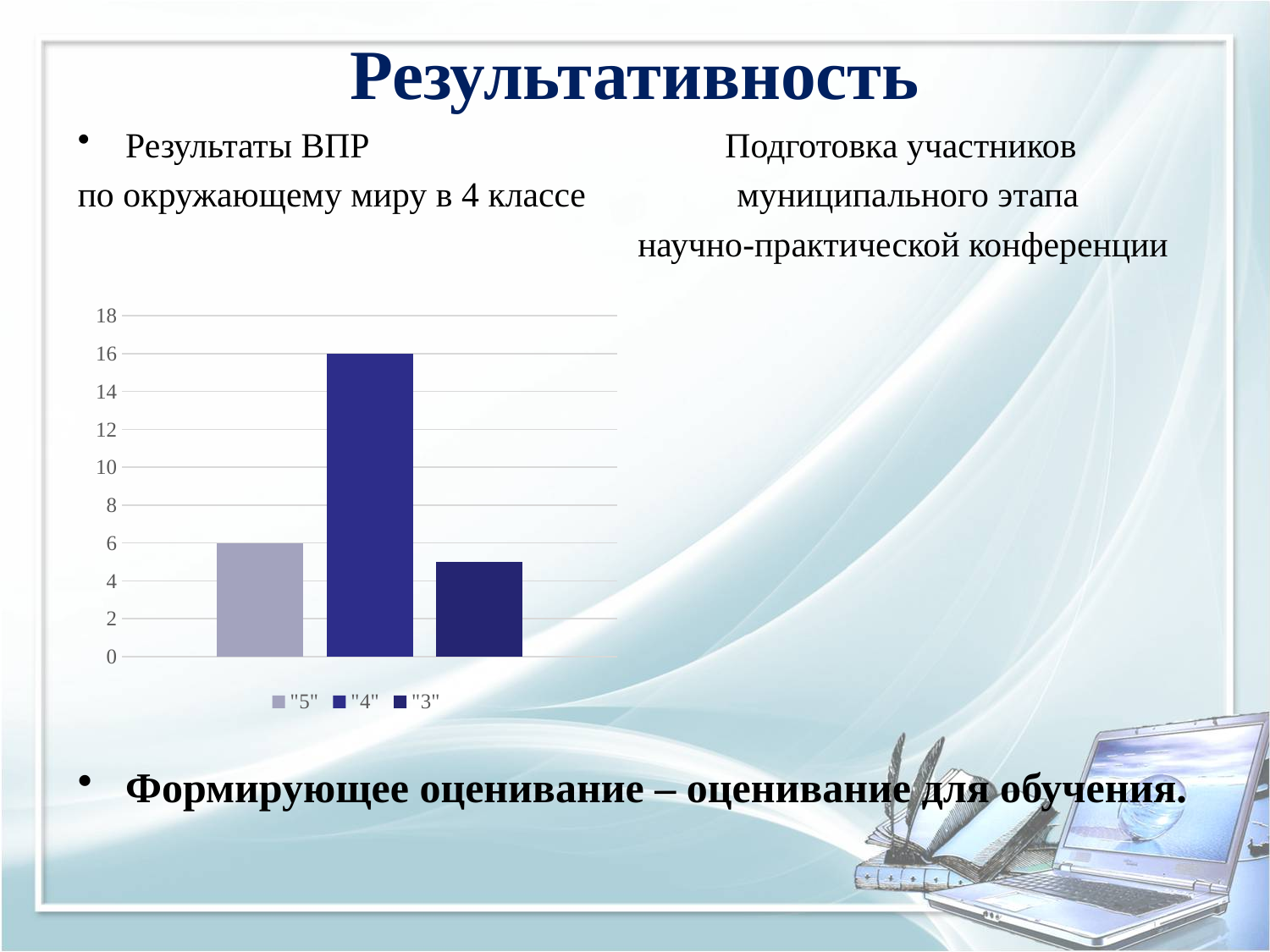
Is the value for "3" greater or less than 4? greater What kind of chart is shown on the slide? bar chart How many series does the chart legend list? 3 How many bars are plotted in the chart? 3 What is the value of the "5" bar in the chart? 6 Which series has the highest bar in the chart? "4" Which is larger, the "5" bar or the "3" bar? "5" Is the value for "3" greater or less than 6? less What is the difference between the "4" bar and the "5" bar? 10 What is the highest value shown on the chart's vertical axis? 18 What is the value of the "4" bar in the chart? 16 Which series has the lowest bar in the chart? "3"